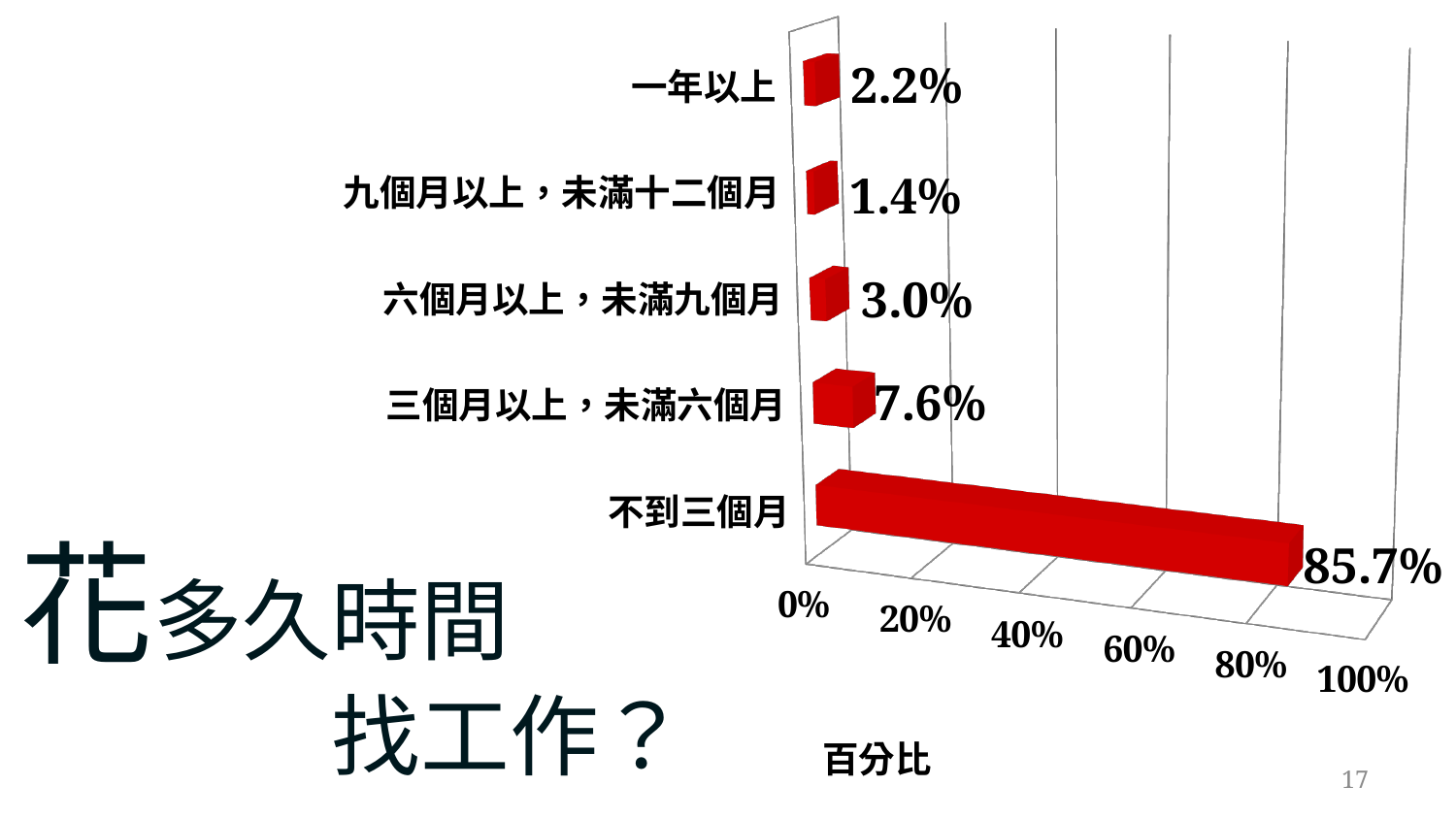
What is the value for 六個月以上，未滿九個月? 3.0% Which is larger, the value for 一年以上 or the value for 六個月以上，未滿九個月? 六個月以上，未滿九個月 What is the value for 一年以上? 2.2% What kind of chart is shown on the slide? Bar chart Is the value for 不到三個月 greater or less than 80%? greater What is the value for 三個月以上，未滿六個月? 7.6% Which category has the lowest value? 九個月以上，未滿十二個月 Which category has the highest value? 不到三個月 What is the difference between the values for 不到三個月 and 三個月以上，未滿六個月? 78.1% How many categories are shown in the chart? 5 What is the value for 不到三個月? 85.7% What is the value for 九個月以上，未滿十二個月? 1.4%